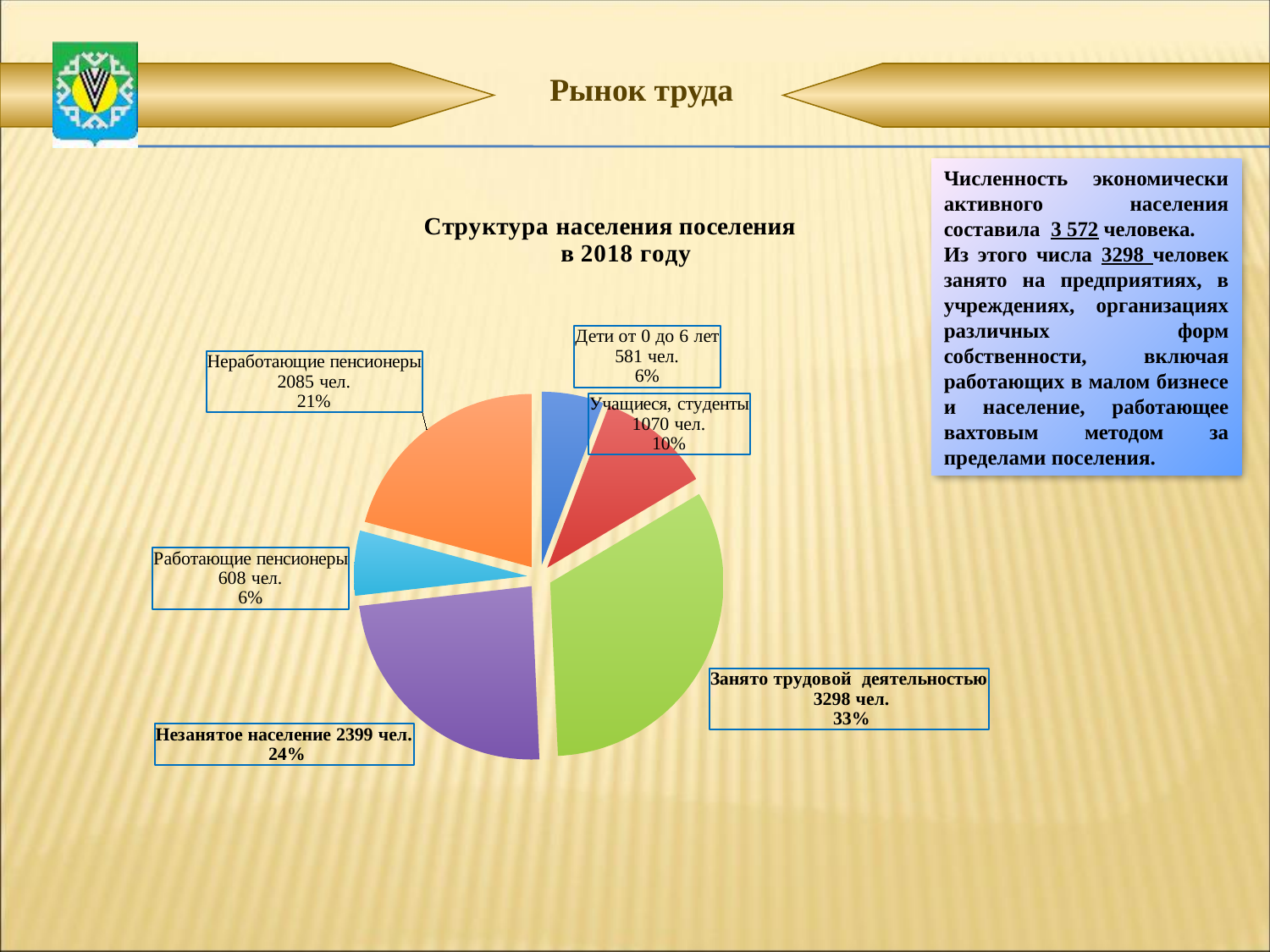
What share of the pie does "Незанятое население" represent? 24% How many slices does the pie chart have? 6 Which category has the largest share of the pie? Занято трудовой деятельностью What is the difference in people between "Учащиеся, студенты" and "Работающие пенсионеры"? 462 чел. What is the difference in people between "Незанятое население" and "Неработающие пенсионеры"? 314 чел. What type of chart is shown on the slide? Pie chart How many people are in the category "Занято трудовой деятельностью"? 3298 чел. How many people are in the category "Дети от 0 до 6 лет"? 581 чел. How many people are in the category "Неработающие пенсионеры"? 2085 чел. What is the title of the chart? Структура населения поселения в 2018 году Which is larger: "Работающие пенсионеры" or "Неработающие пенсионеры"? Неработающие пенсионеры What percentage is shown for "Учащиеся, студенты"? 10%